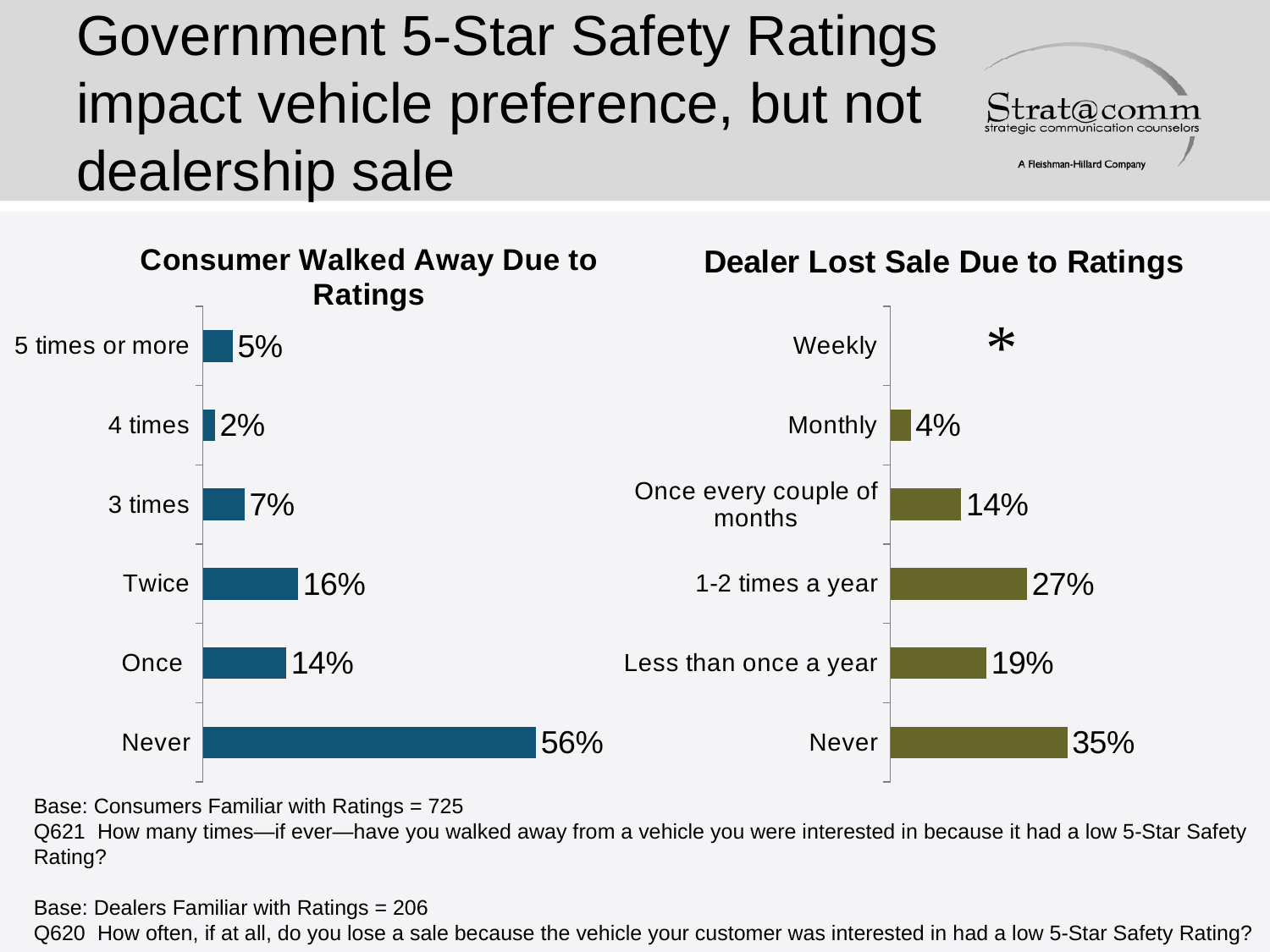
In the 'Dealer Lost Sale Due to Ratings' chart, what symbol is shown instead of a bar for Weekly? * In the 'Consumer Walked Away Due to Ratings' chart, what is the value for Never? 56% In the 'Dealer Lost Sale Due to Ratings' chart, what is the value for 1-2 times a year? 27% In the 'Dealer Lost Sale Due to Ratings' chart, which labelled category has the highest value? Never In the 'Dealer Lost Sale Due to Ratings' chart, what is the difference between 1-2 times a year and Less than once a year? 8% In the 'Consumer Walked Away Due to Ratings' chart, what is the value for Twice? 16% In the 'Consumer Walked Away Due to Ratings' chart, which category has the lowest value? 4 times In the 'Consumer Walked Away Due to Ratings' chart, which is larger: Once or 3 times? Once In the 'Dealer Lost Sale Due to Ratings' chart, what is the value for Once every couple of months? 14% In the 'Consumer Walked Away Due to Ratings' chart, what is the difference between Never and Twice? 40% What kind of chart is the 'Consumer Walked Away Due to Ratings' chart? Bar chart How many categories are shown in the 'Dealer Lost Sale Due to Ratings' chart? 6